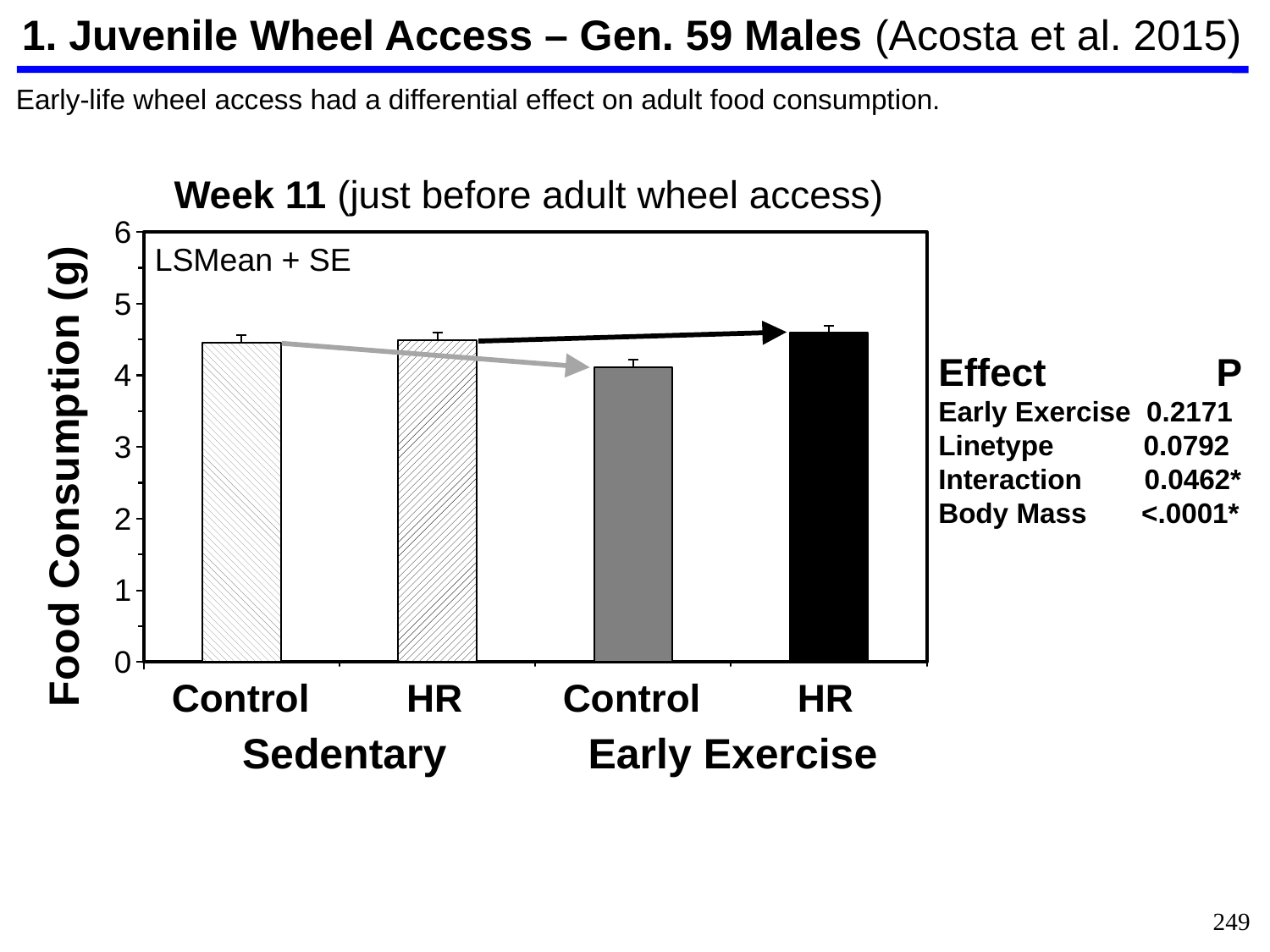
Is the value for the Early Exercise Control bar greater or less than 5? less Which bar shows the lowest food consumption? Early Exercise Control What is the title of the chart? Week 11 (just before adult wheel access) Within the Early Exercise group, which bar is larger, Control or HR? HR Is the value for the Sedentary Control bar greater or less than 3? greater How many bars are plotted in the chart? 4 What kind of chart is shown on the slide? bar chart Which is larger, the Sedentary Control bar or the Early Exercise Control bar? Sedentary Control What is the label of the y axis? Food Consumption (g) Is the value for the Early Exercise HR bar greater or less than 4? greater